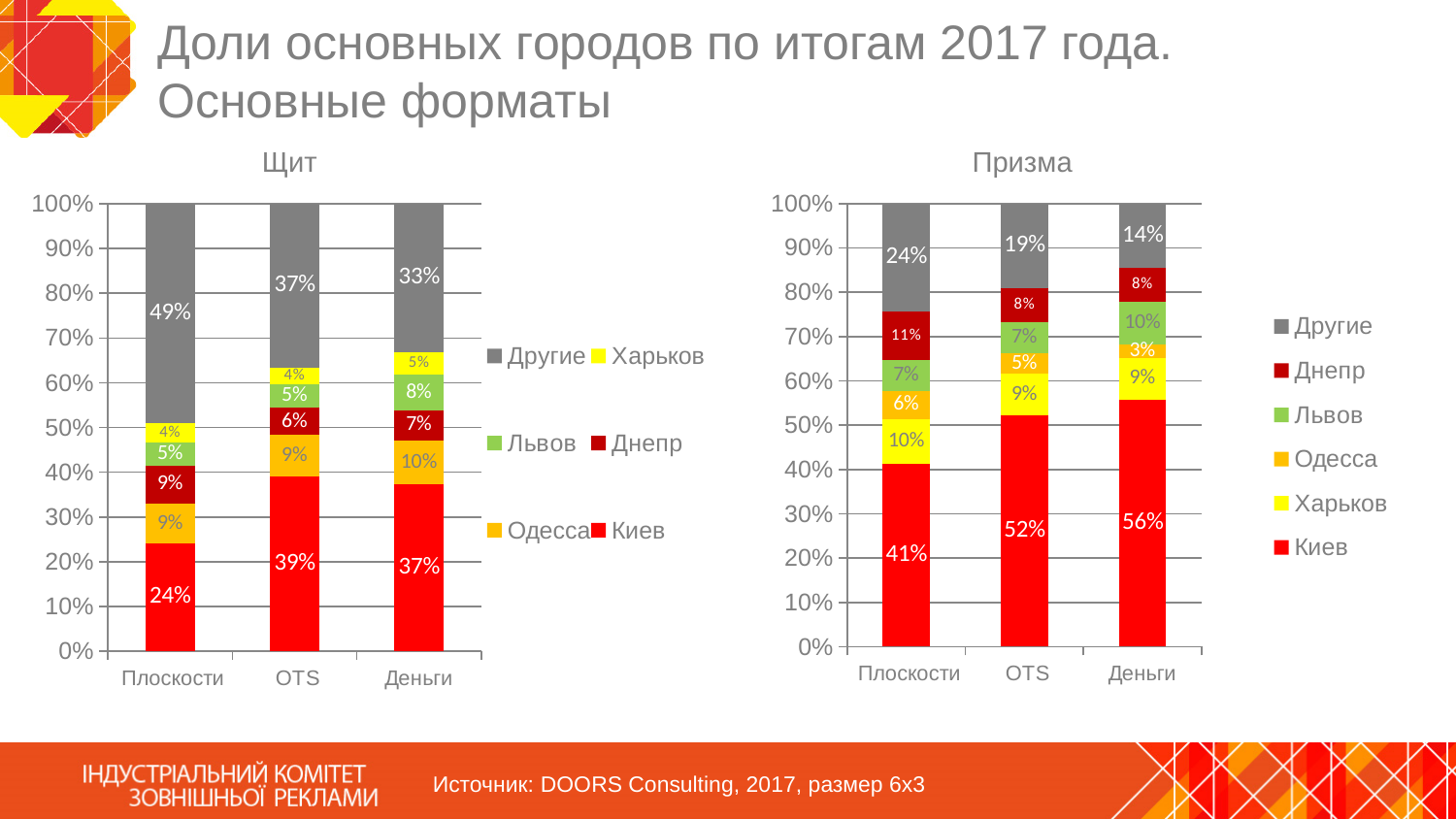
In the "Щит" chart, what is the value for Киев in the Плоскости category? 24% In the "Призма" chart, does the value for Киев rise or fall from Плоскости to Деньги? rise In the "Призма" chart, which category has the lowest value for Киев? Плоскости In the "Щит" chart, what is the value for Другие in the OTS category? 37% In the "Призма" chart, what is the difference between the Киев values for Деньги and Плоскости? 15% What kind of chart is the "Призма" chart? stacked bar chart In the "Призма" chart, what is the value for Киев in the Деньги category? 56% How many series does the legend of the "Призма" chart list? 6 In the "Щит" chart, which is larger: Киев in OTS or Киев in Деньги? Киев in OTS In the "Призма" chart, what is the value for Днепр in the Плоскости category? 11% How many categories are shown on the x axis of the "Щит" chart? 3 In the "Щит" chart, which category has the highest value for Другие? Плоскости